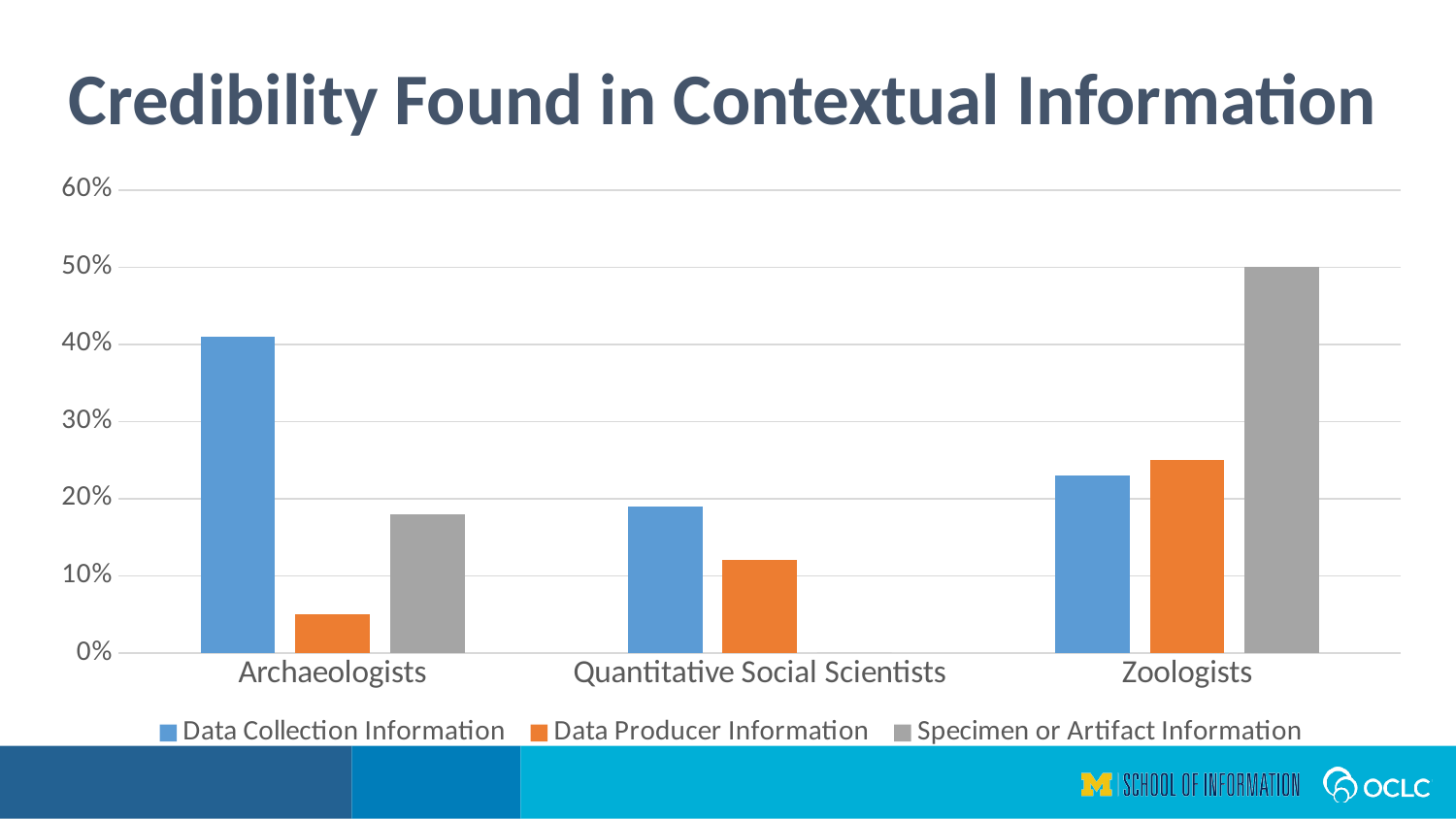
Which category has the highest value for Specimen or Artifact Information? Zoologists How many categories are shown on the x axis? 3 Which is larger for Archaeologists: Data Collection Information or Specimen or Artifact Information? Data Collection Information How many series does the legend list? 3 Which category has the highest value for Data Collection Information? Archaeologists What is the title of the chart? Credibility Found in Contextual Information What kind of chart is shown on the slide? bar chart Which is larger for Zoologists: Specimen or Artifact Information or Data Collection Information? Specimen or Artifact Information Which category has the lowest value for Data Producer Information? Archaeologists Is the value for Data Producer Information for Archaeologists greater or less than 10%? less